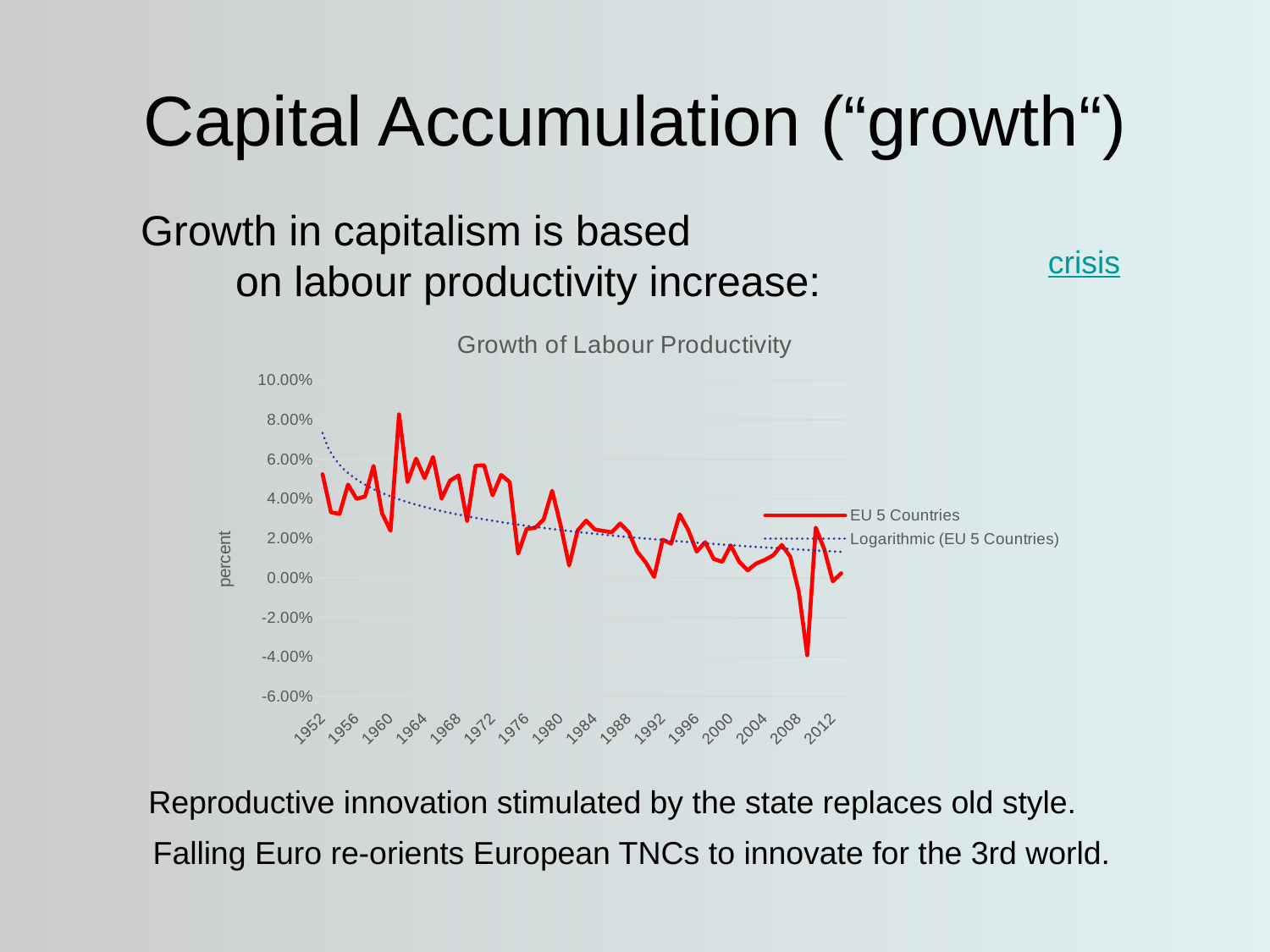
Which series in the chart is drawn as a dotted line? Logarithmic (EU 5 Countries) What is the title of the chart? Growth of Labour Productivity Is the Logarithmic (EU 5 Countries) trendline value at 1952 greater or less than 6.00%? greater Is the EU 5 Countries value for 1952 greater or less than 2.00%? greater Is the highest value of the EU 5 Countries line greater or less than 6.00%? greater How many year labels are shown on the x axis of the chart? 16 Overall, does the EU 5 Countries line rise or fall from 1952 to 2012? fall How many series does the chart's legend list? 2 What kind of chart is shown on the slide? line chart Which is larger for the EU 5 Countries series: the value in 1952 or the value in 2012? 1952